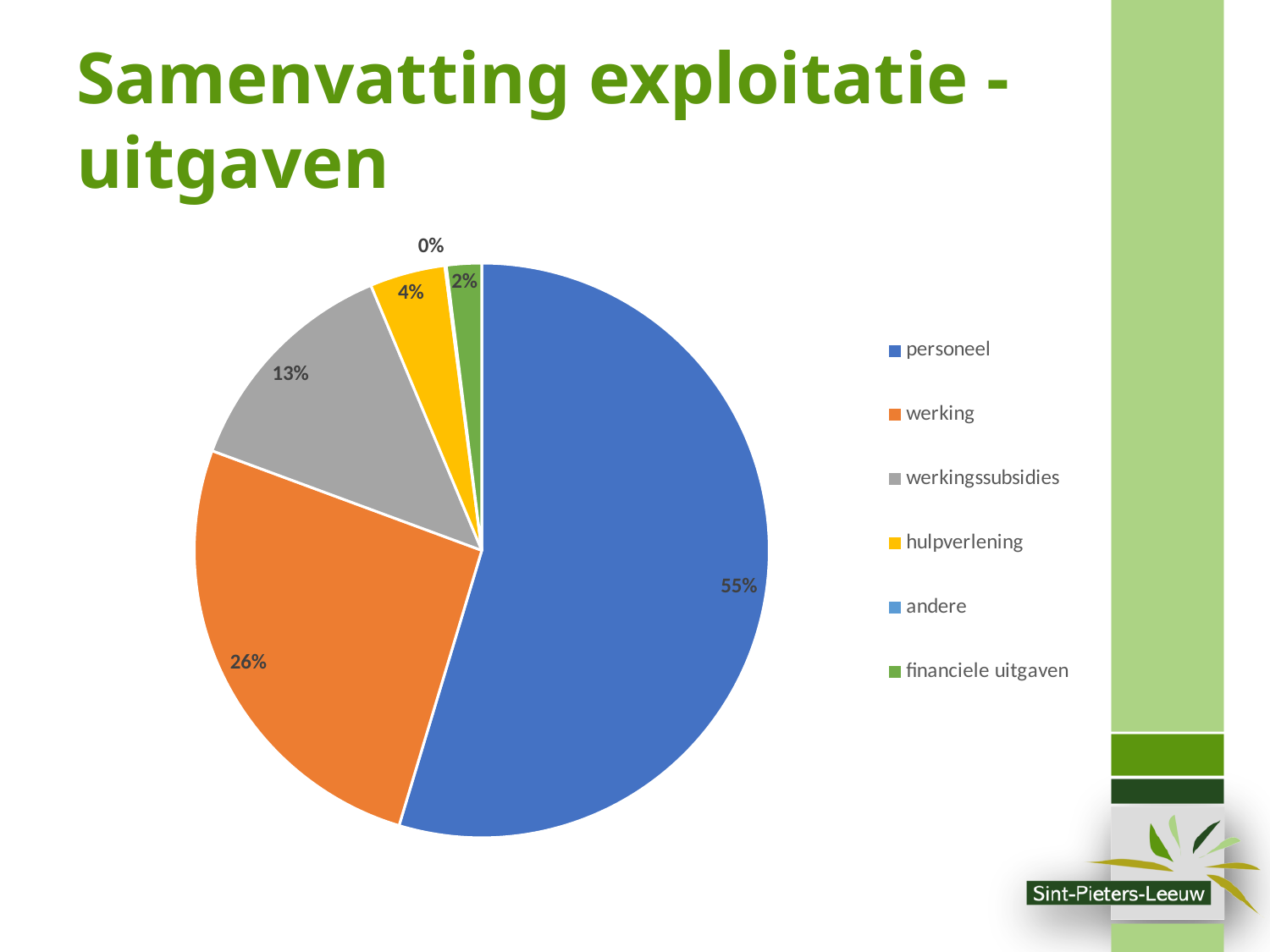
What percentage is shown for andere? 0% What percentage is shown for werkingssubsidies? 13% What kind of chart is shown on the slide? pie chart What share of the pie does personeel represent? 55% Which category has the largest share of the pie? personeel How many categories does the legend list? 6 What is the difference in percentage points between personeel and werking? 29 What percentage is shown for hulpverlening? 4% What share of the pie does werking represent? 26% Which is larger, the share for werkingssubsidies or the share for hulpverlening? werkingssubsidies Which category has the smallest share of the pie? andere What percentage is shown for financiele uitgaven? 2%